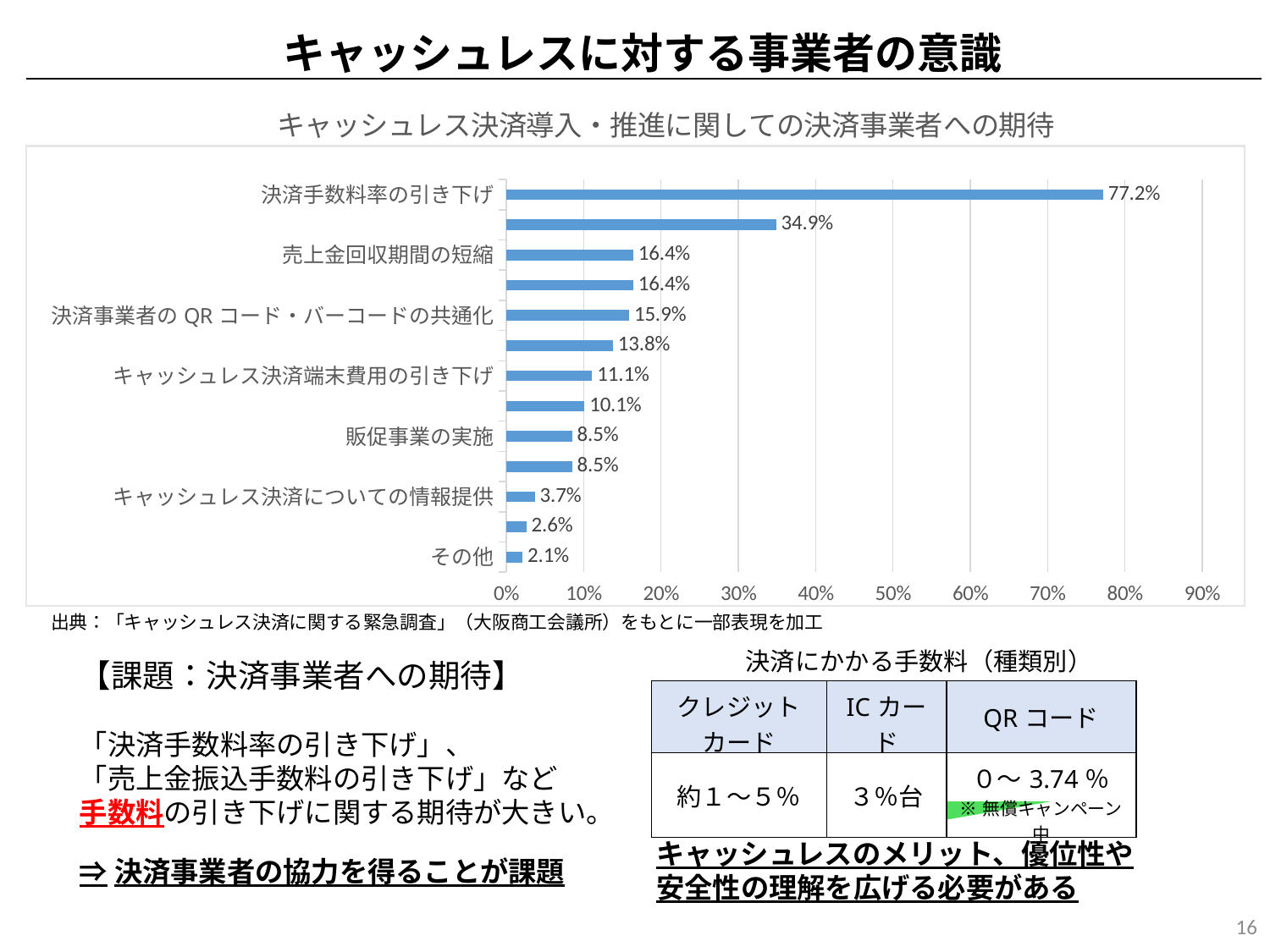
What is the value for 決済手数料率の引き下げ? 77.2% What is the value for 売上金回収期間の短縮? 16.4% What is the value for 決済事業者の QR コード・バーコードの共通化? 15.9% What is the title of the chart? キャッシュレス決済導入・推進に関しての決済事業者への期待 Which is larger, the value for キャッシュレス決済端末費用の引き下げ or the value for 販促事業の実施? キャッシュレス決済端末費用の引き下げ What is the value for キャッシュレス決済端末費用の引き下げ? 11.1% How many bars are plotted in the chart? 13 What is the value for キャッシュレス決済についての情報提供? 3.7% Which category has the lowest value? その他 What is the difference between the values for 決済手数料率の引き下げ and 売上金回収期間の短縮? 60.8 percentage points What type of chart is shown on the slide? bar chart Which category has the highest value? 決済手数料率の引き下げ